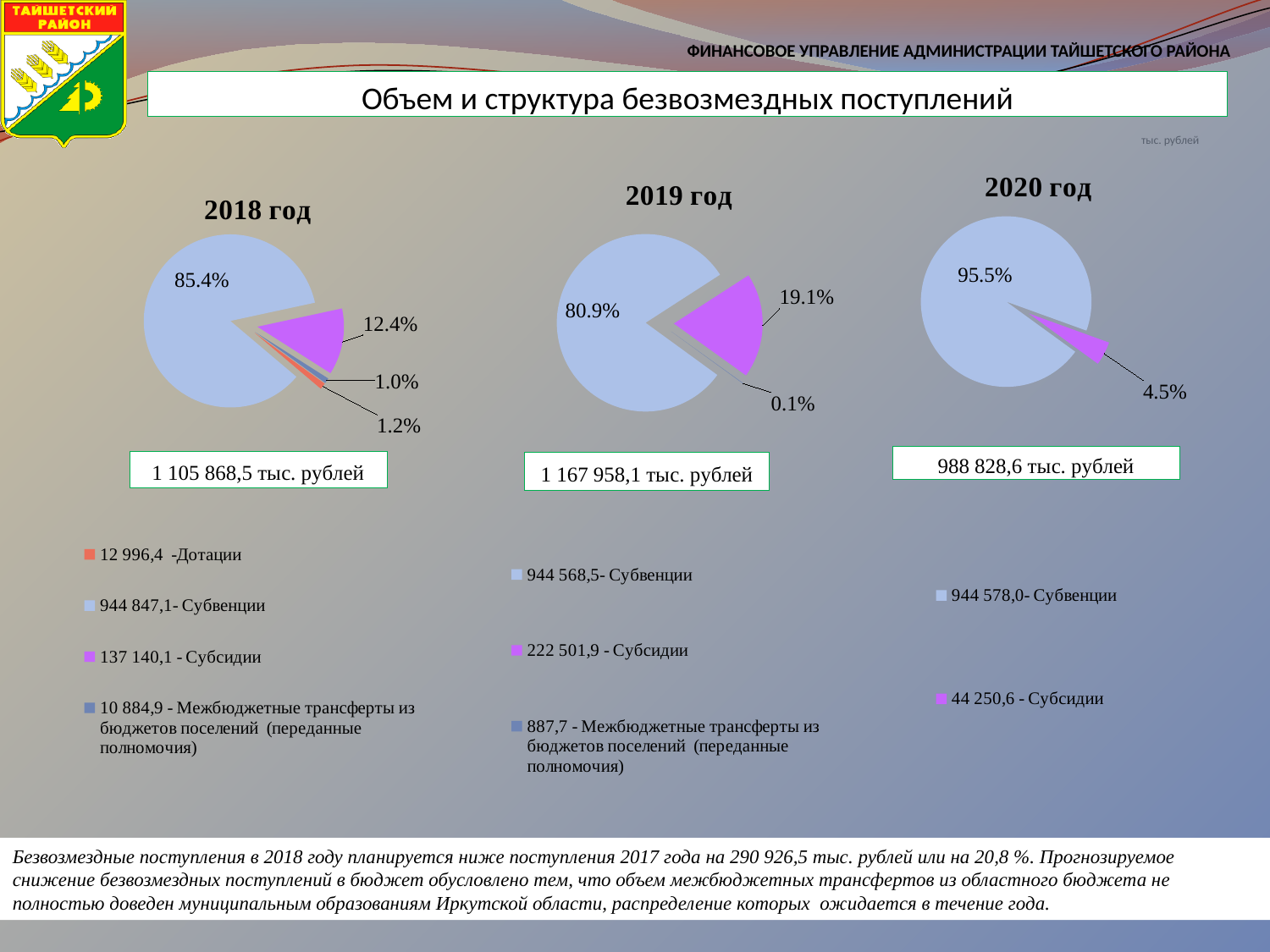
In the 2020 год chart, what share of the pie is Субвенции? 95.5% How many slices does the 2018 год pie chart have? 4 How many categories does the legend of the 2020 год chart list? 2 What type of chart is used for the 2018 год chart? pie chart In the 2018 год chart, what is the value for Дотации according to the legend? 12 996,4 In the 2018 год chart, what share of the pie is Субвенции? 85.4% What total is shown in the box below the 2020 год chart? 988 828,6 тыс. рублей Which is larger: the Субсидии share in the 2019 год chart or the Субсидии share in the 2020 год chart? 2019 год In the 2019 год chart, what share of the pie is Субсидии? 19.1% In the 2019 год chart, which category has the smallest share? Межбюджетные трансферты из бюджетов поселений (переданные полномочия) In the 2019 год chart, what is the value for Субвенции according to the legend? 944 568,5